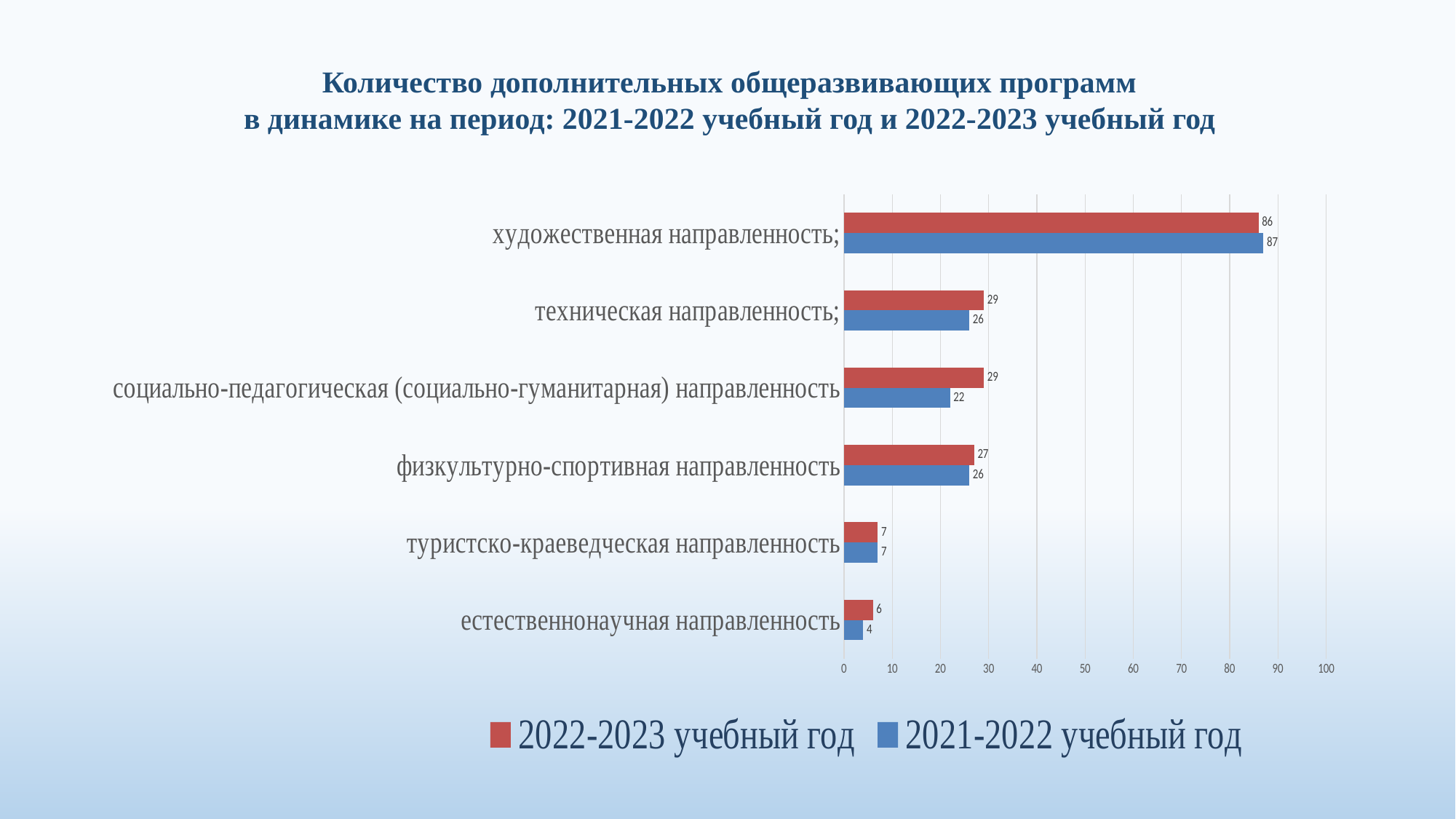
How many series does the legend list? 2 What kind of chart is shown on the slide? bar chart What is the value for художественная направленность in the 2022-2023 учебный год series? 86 Which colour represents the 2021-2022 учебный год series? blue What is the value for художественная направленность in the 2021-2022 учебный год series? 87 What is the difference between the 2022-2023 and 2021-2022 values for социально-педагогическая (социально-гуманитарная) направленность? 7 Which category has the lowest value in the 2021-2022 учебный год series? естественнонаучная направленность What is the value for социально-педагогическая (социально-гуманитарная) направленность in the 2021-2022 учебный год series? 22 What is the value for естественнонаучная направленность in the 2022-2023 учебный год series? 6 For техническая направленность, which series has the larger value: 2022-2023 учебный год or 2021-2022 учебный год? 2022-2023 учебный год Which category has the highest value in the 2022-2023 учебный год series? художественная направленность How many categories are shown on the chart? 6